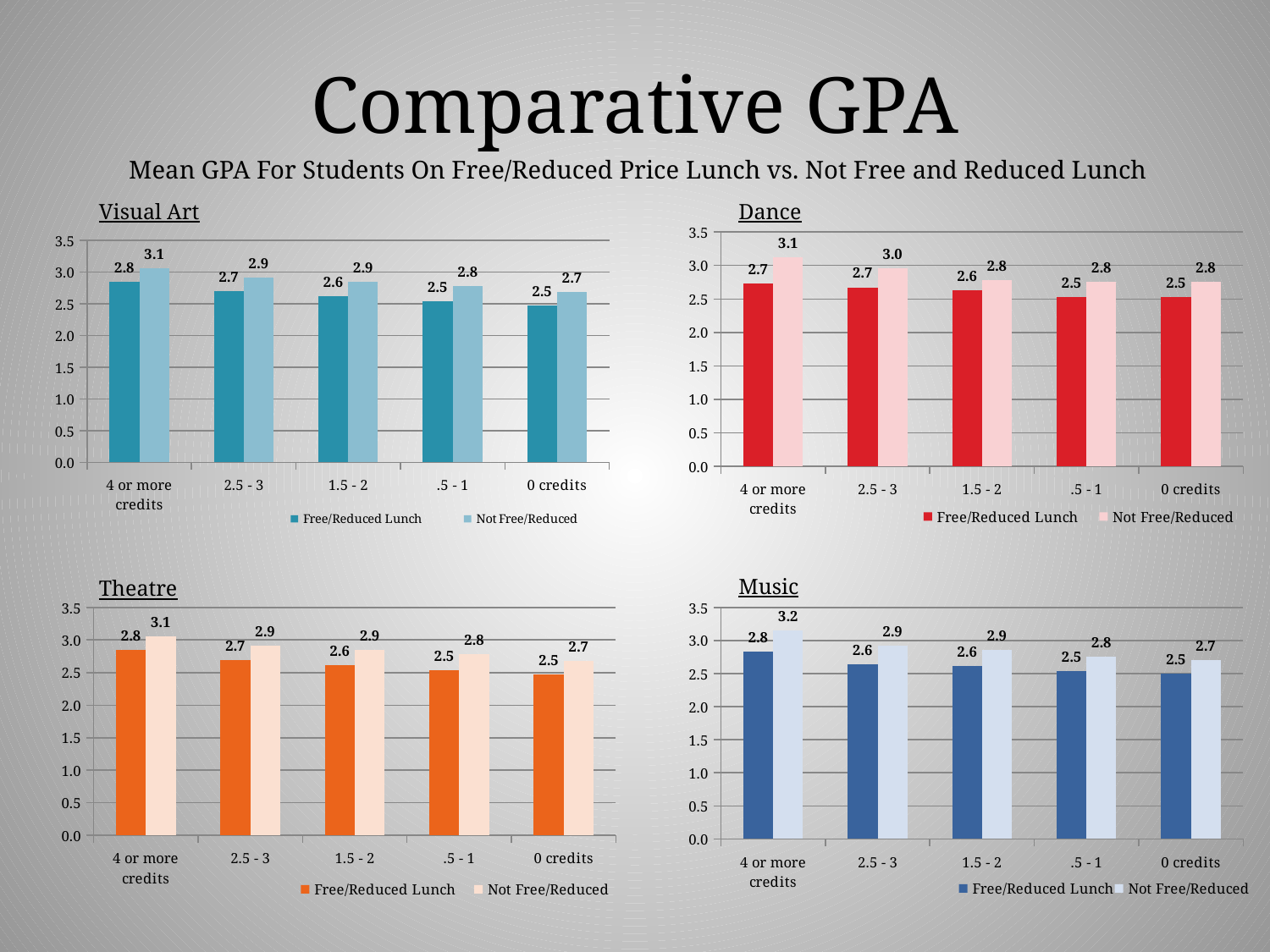
In the Dance chart, what is the difference between the Not Free/Reduced and Free/Reduced Lunch mean GPA for 4 or more credits? 0.4 How many credit categories are shown on the x axis of the Visual Art chart? 5 In the Visual Art chart, what is the mean GPA for Free/Reduced Lunch students with 4 or more credits? 2.8 In the Theatre chart, what is the mean GPA for Free/Reduced Lunch students with 0 credits? 2.5 In the Visual Art chart, do the Free/Reduced Lunch values rise or fall from 4 or more credits to 0 credits? Fall How many series does the legend of the Dance chart list? 2 What type of chart is the Music chart? Bar chart In the Theatre chart, which is larger for 2.5 - 3 credits: the Free/Reduced Lunch GPA or the Not Free/Reduced GPA? Not Free/Reduced In the Music chart, which credit category has the highest Not Free/Reduced mean GPA? 4 or more credits What is the subtitle shown below the slide title 'Comparative GPA'? Mean GPA For Students On Free/Reduced Price Lunch vs. Not Free and Reduced Lunch In the Music chart, what is the mean GPA for Not Free/Reduced students with 4 or more credits? 3.2 In the Dance chart, what is the mean GPA for Not Free/Reduced students with 4 or more credits? 3.1